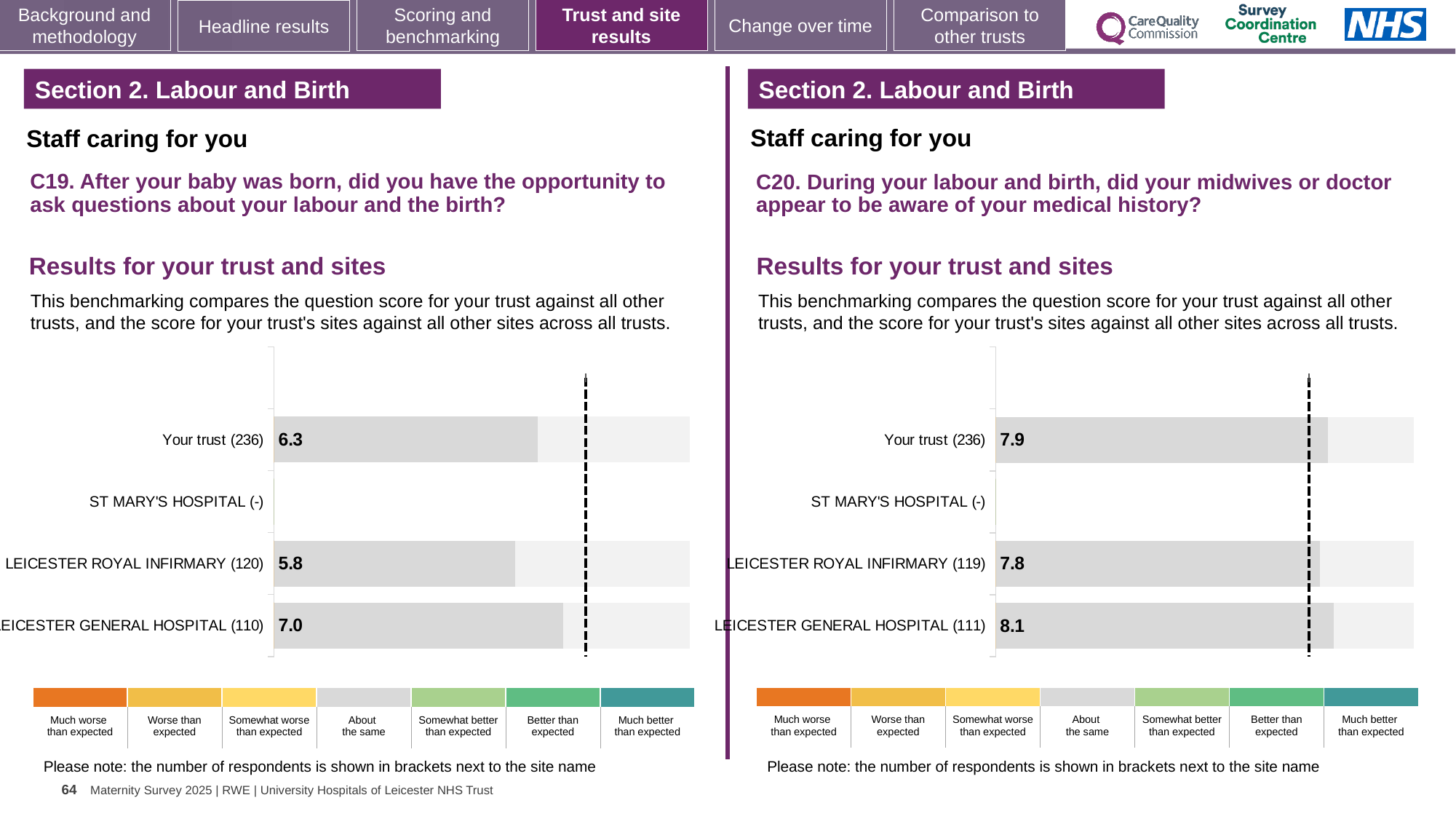
In the right chart (C20), what is the score for Your trust (236)? 7.9 In the right chart (C20), what is the difference between the scores for LEICESTER GENERAL HOSPITAL (111) and Your trust (236)? 0.2 In the right chart (C20), which site has the lowest score among those with a value shown? LEICESTER ROYAL INFIRMARY (119) In the left chart (C19), which site has the highest score? LEICESTER GENERAL HOSPITAL (110) In the left chart (C19), what is the difference between the scores for LEICESTER GENERAL HOSPITAL (110) and LEICESTER ROYAL INFIRMARY (120)? 1.2 In the left chart (C19), what is the score for LEICESTER ROYAL INFIRMARY (120)? 5.8 What kind of chart is used in the left chart (C19)? Bar chart In the left chart (C19), what is the score for LEICESTER GENERAL HOSPITAL (110)? 7.0 In the right chart (C20), what is the score for LEICESTER GENERAL HOSPITAL (111)? 8.1 How many rows (categories) are listed on the y axis of the right chart (C20)? 4 In the left chart (C19), what is the score for Your trust (236)? 6.3 In the right chart (C20), what is the score for LEICESTER ROYAL INFIRMARY (119)? 7.8